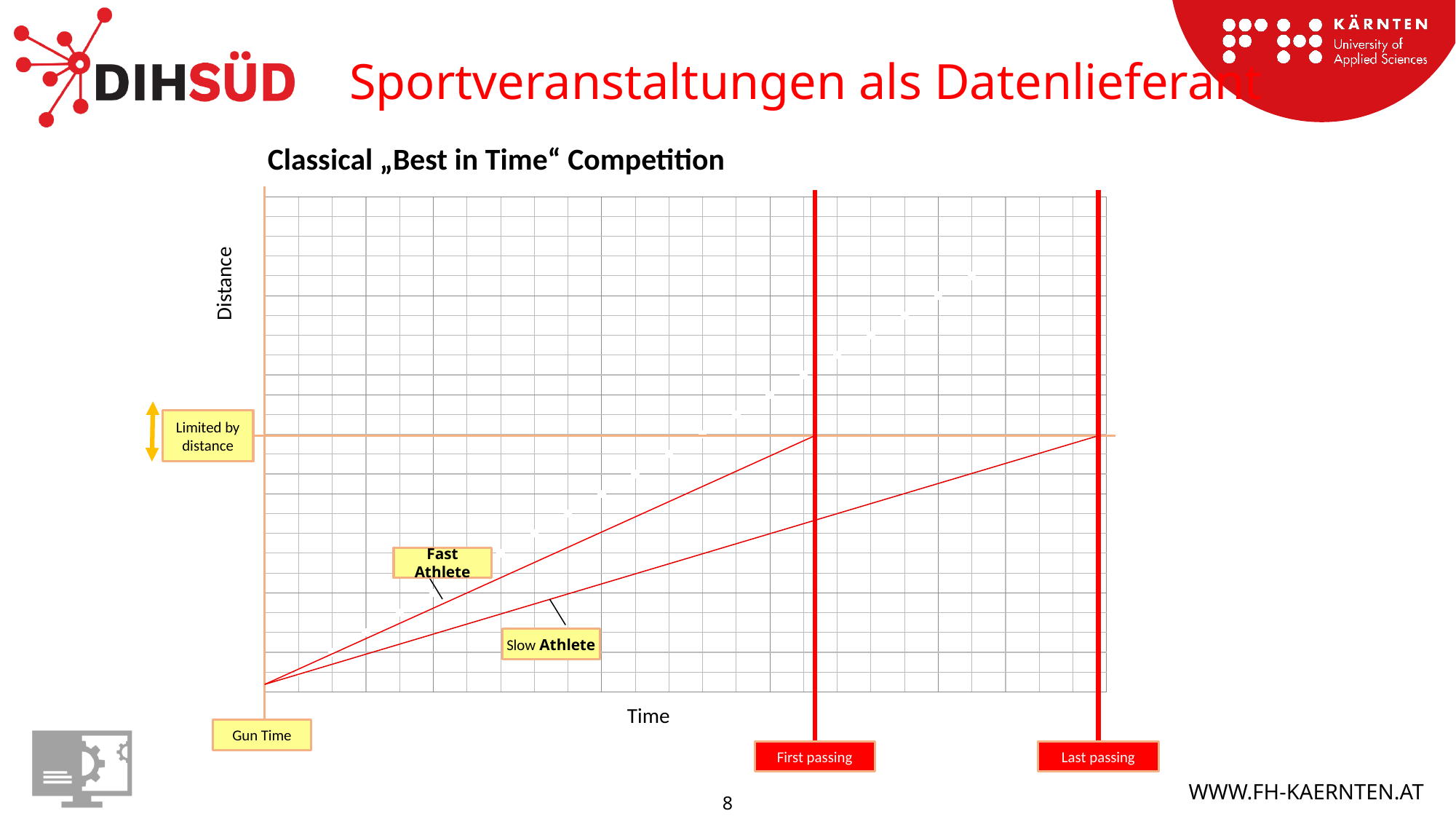
At the 'First passing' marker, which athlete has covered more distance? Fast Athlete Which athlete's line is steeper, the Fast Athlete or the Slow Athlete? Fast Athlete At which vertical red marker does the Fast Athlete reach the 'Limited by distance' line? First passing How many athlete lines are plotted in the chart? 2 What is the title of the chart? Classical „Best in Time“ Competition Do the athlete lines rise or fall as time increases along the x axis? rise What are the labels of the x axis and the y axis of the chart? Time (x axis) and Distance (y axis) What kind of chart is shown on the slide? line chart